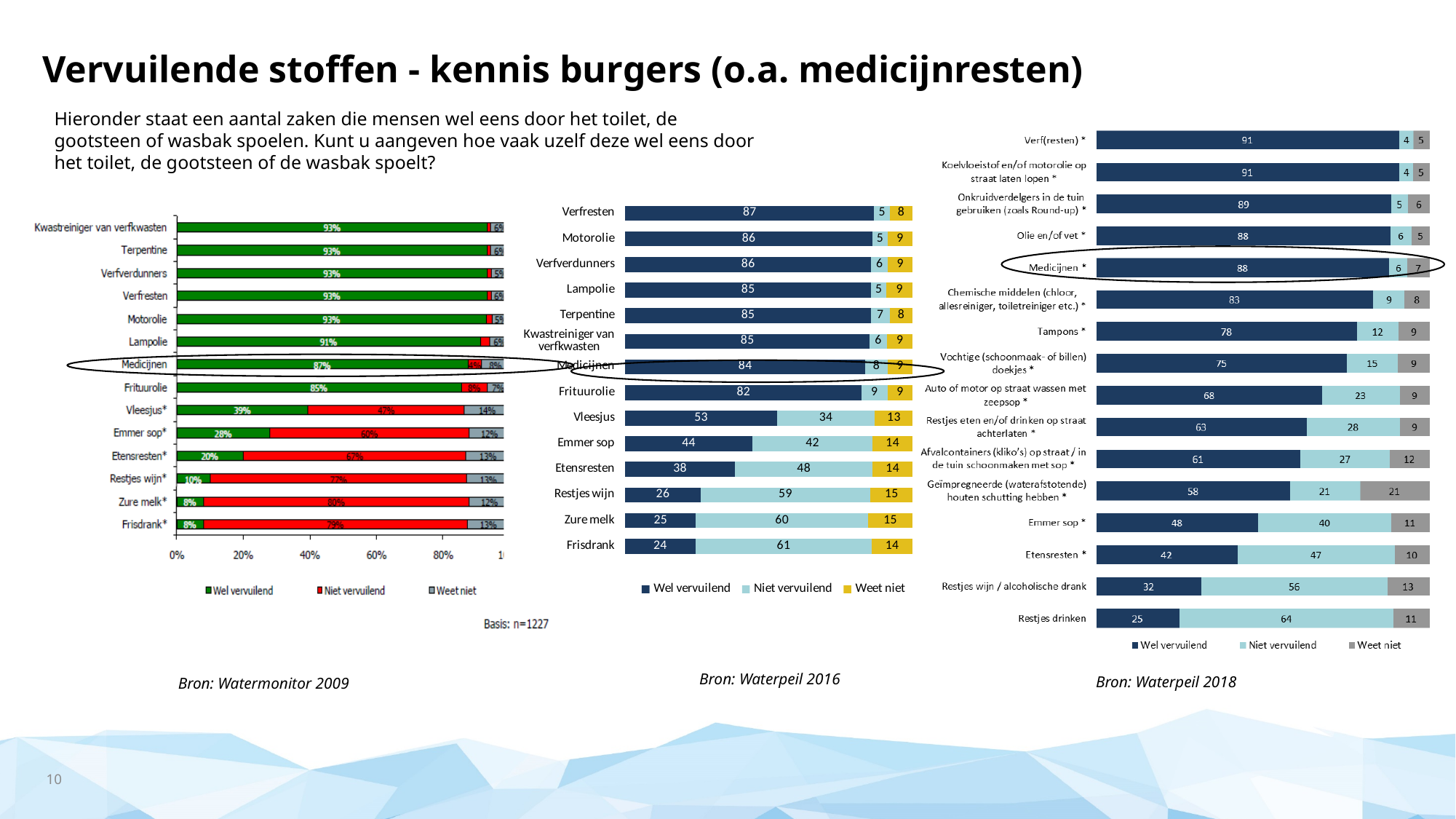
In the left chart (Bron: Watermonitor 2009), what is the 'Wel vervuilend' percentage for Medicijnen? 87% In the middle chart (Bron: Waterpeil 2016), which category has the lowest 'Wel vervuilend' value? Frisdrank In the right chart (Bron: Waterpeil 2018), what is the 'Niet vervuilend' value for Tampons? 12 In the right chart (Bron: Waterpeil 2018), what is the difference between the 'Wel vervuilend' values for Medicijnen and Etensresten? 46 How many series does the legend of the middle chart (Bron: Waterpeil 2016) list? 3 In the middle chart (Bron: Waterpeil 2016), what is the 'Wel vervuilend' value for Medicijnen? 84 In the left chart (Bron: Watermonitor 2009), what is the 'Weet niet' percentage for Vleesjus? 14% In the middle chart (Bron: Waterpeil 2016), which category has the highest 'Wel vervuilend' value? Verfresten How many categories are shown in the right chart (Bron: Waterpeil 2018)? 16 In the middle chart (Bron: Waterpeil 2016), what is the total of the three segments for Vleesjus? 100 What type of chart is the middle chart (Bron: Waterpeil 2016)? Stacked bar chart In the right chart (Bron: Waterpeil 2018), which has a larger 'Niet vervuilend' value: Emmer sop or Restjes drinken? Restjes drinken